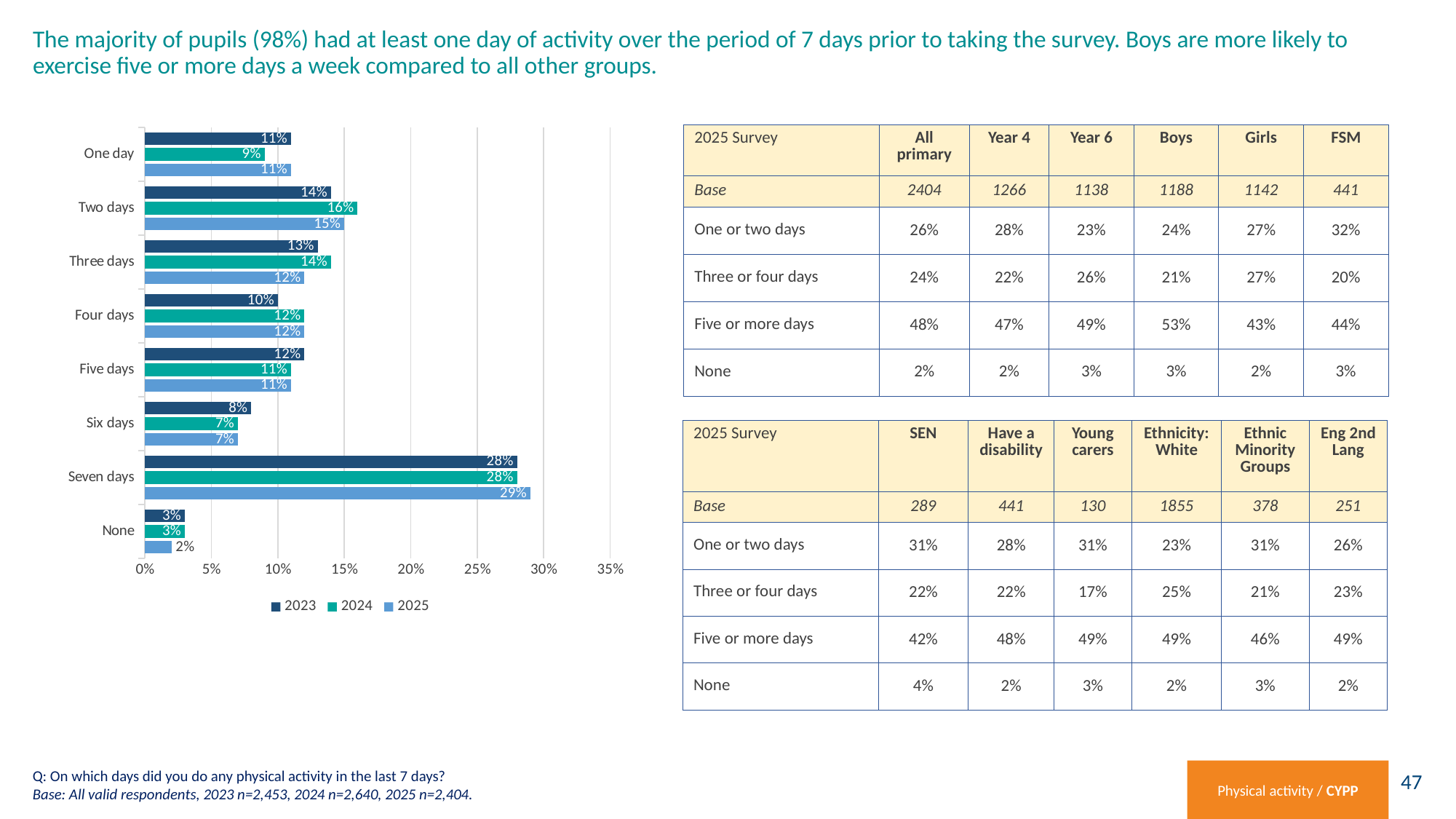
What are the series names listed in the chart legend? 2023, 2024, 2025 Which is larger for Two days: the 2023 value or the 2024 value? 2024 What is the 2024 value for Two days? 16% Which category has the highest value in the 2025 series? Seven days Is the 2023 value for Seven days greater or less than 25%? greater How many categories are shown on the chart? 8 What is the difference between the 2024 and 2025 values for Three days? 2% What is the 2023 value for Four days? 10% How many series does the legend list? 3 What is the 2025 value for Seven days? 29% What kind of chart is shown on the slide? Bar chart Which category has the lowest value in the 2025 series? None